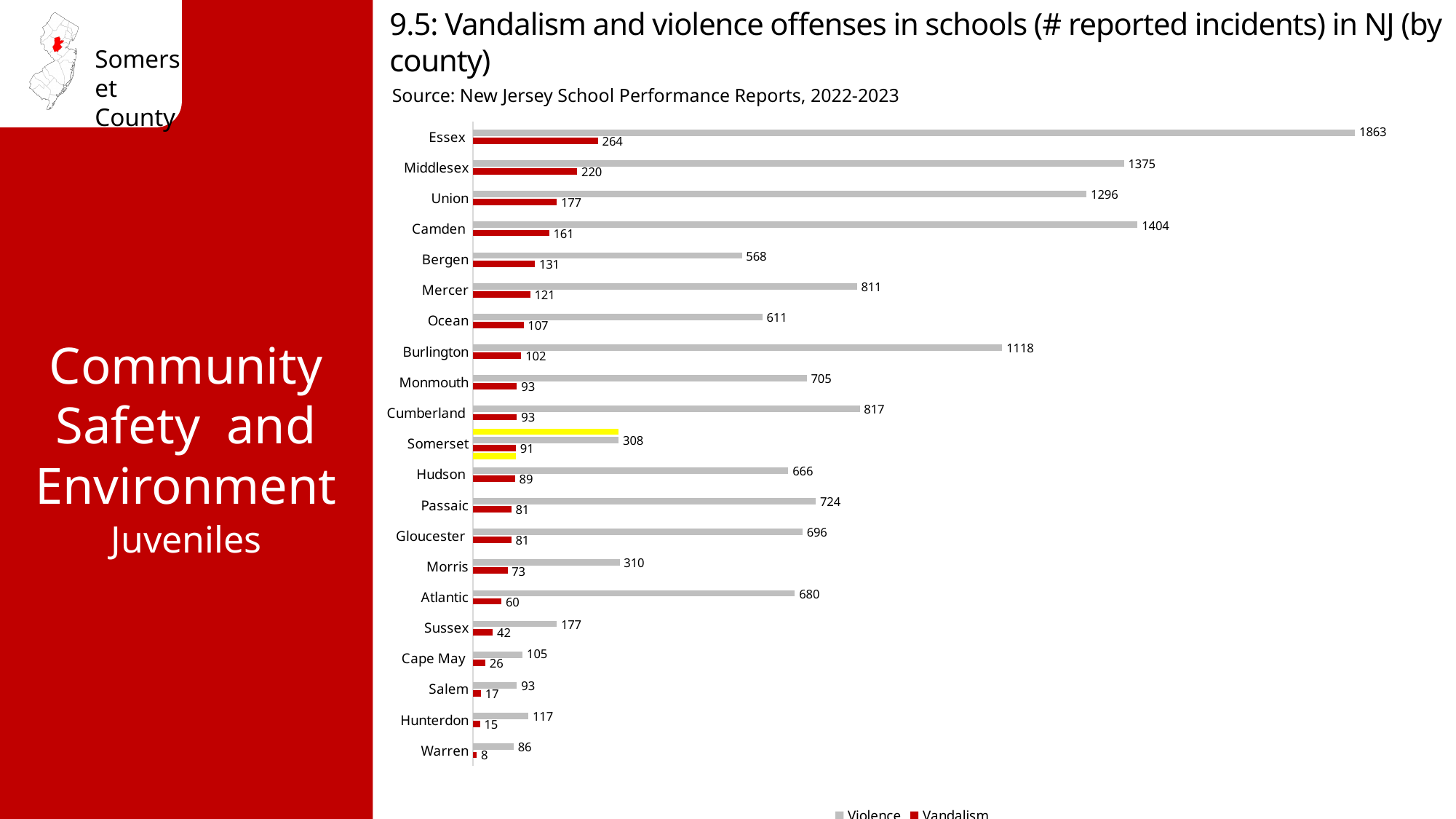
How many counties are shown in the chart? 21 Which series is shown in red in the chart? Vandalism What type of chart is shown on the slide? Bar chart What is the difference between the violence incidents in Essex and Middlesex? 488 Which county has the lowest number of reported vandalism incidents? Warren What is the number of reported vandalism incidents in Somerset County? 91 What is the number of reported violence incidents in Somerset County? 308 Which county has the highest number of reported violence incidents? Essex How many series does the legend list? 2 Which county has more reported violence incidents, Camden or Union? Camden What is the difference between violence and vandalism incidents in Somerset County? 217 How many violence incidents were reported in Camden County? 1404